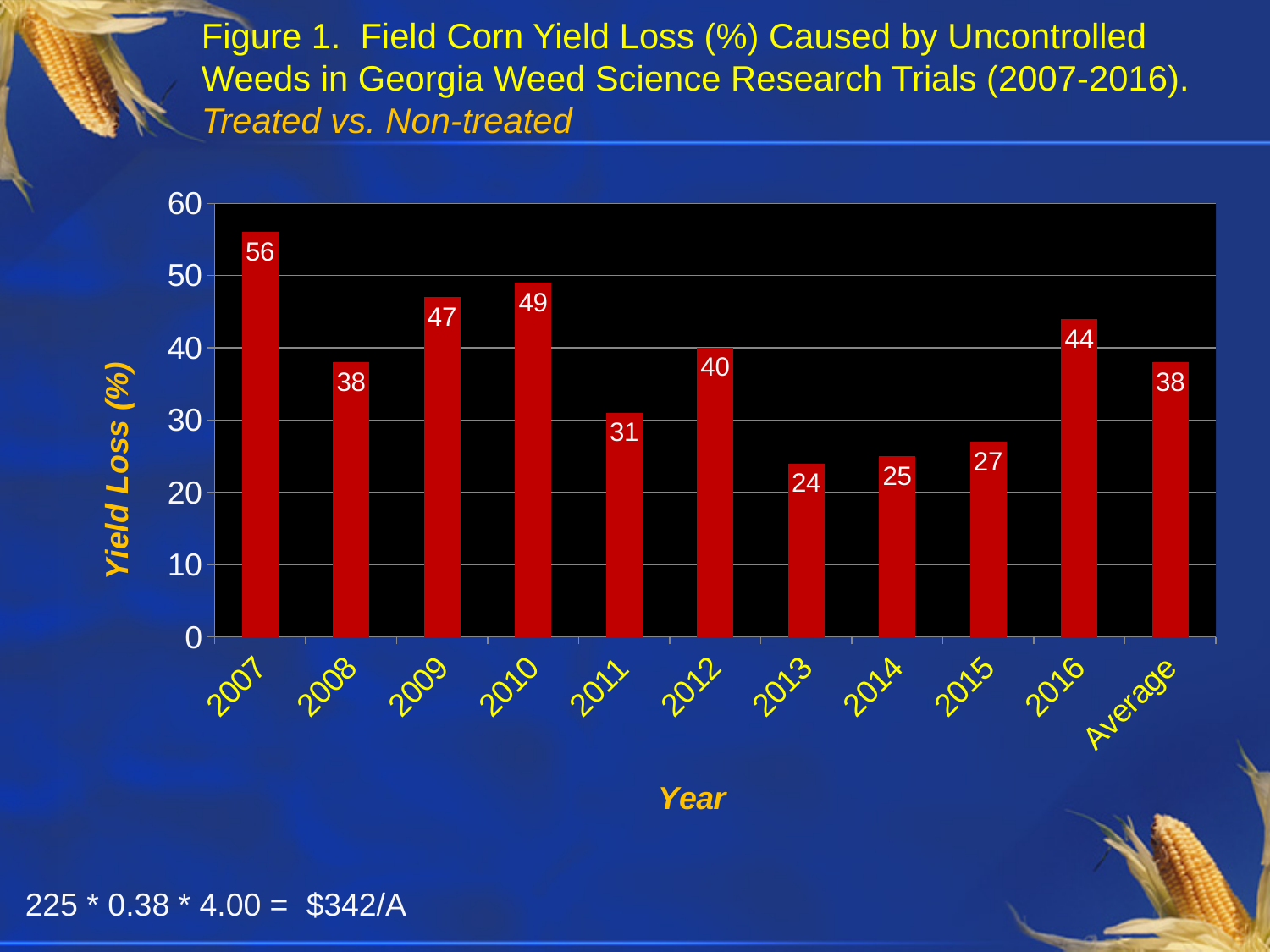
Which year has the lowest yield loss? 2013 Is the yield loss for 2012 greater or less than 30? greater What kind of chart is shown on the slide? bar chart How many bars are plotted in the chart? 11 What is the yield loss (%) for 2013? 24 What is the label of the y axis? Yield Loss (%) Which year has a larger yield loss, 2009 or 2016? 2009 Does the yield loss rise or fall from 2013 to 2016? rise Which year has the highest yield loss? 2007 What is the difference in yield loss between 2010 and 2011? 18 What is the yield loss (%) for 2007? 56 What is the Average yield loss (%) shown in the chart? 38